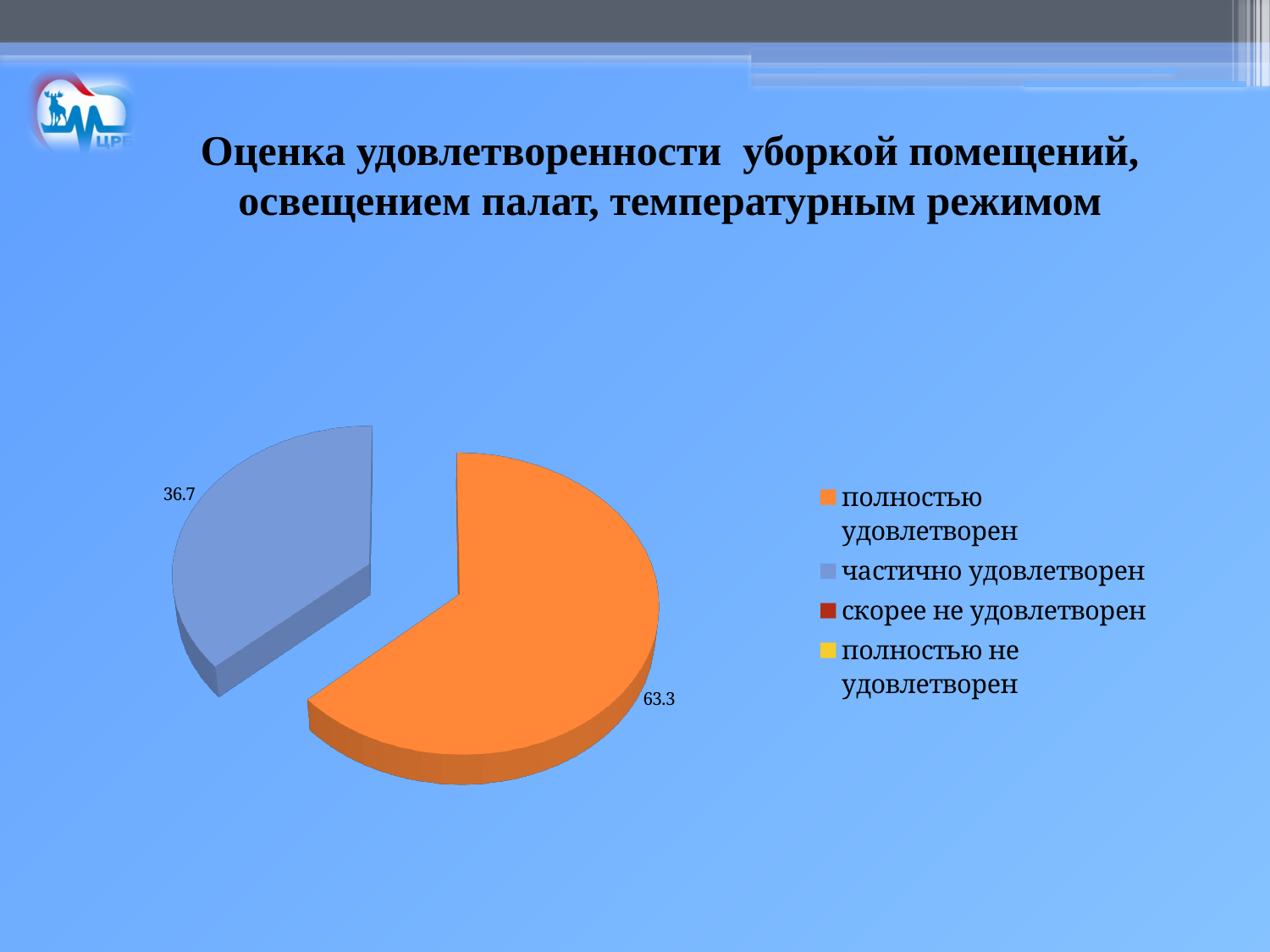
What is the difference between the values for "полностью удовлетворен" and "частично удовлетворен"? 26.6 What value is shown for the "частично удовлетворен" slice of the pie chart? 36.7 What is the title of the slide containing the pie chart? Оценка удовлетворенности уборкой помещений, освещением палат, температурным режимом What colour is the "полностью удовлетворен" slice in the pie chart? orange What value is shown for the "полностью удовлетворен" slice of the pie chart? 63.3 How many slices are visible in the pie chart? 2 How many entries does the legend of the pie chart list? 4 What kind of chart is shown on the slide? pie chart Which category has the largest slice in the pie chart? полностью удовлетворен What is the total of the two labelled values in the pie chart? 100 Which of the two labelled slices in the pie chart is the smallest? частично удовлетворен Which is larger: the value for "полностью удовлетворен" or for "частично удовлетворен"? полностью удовлетворен